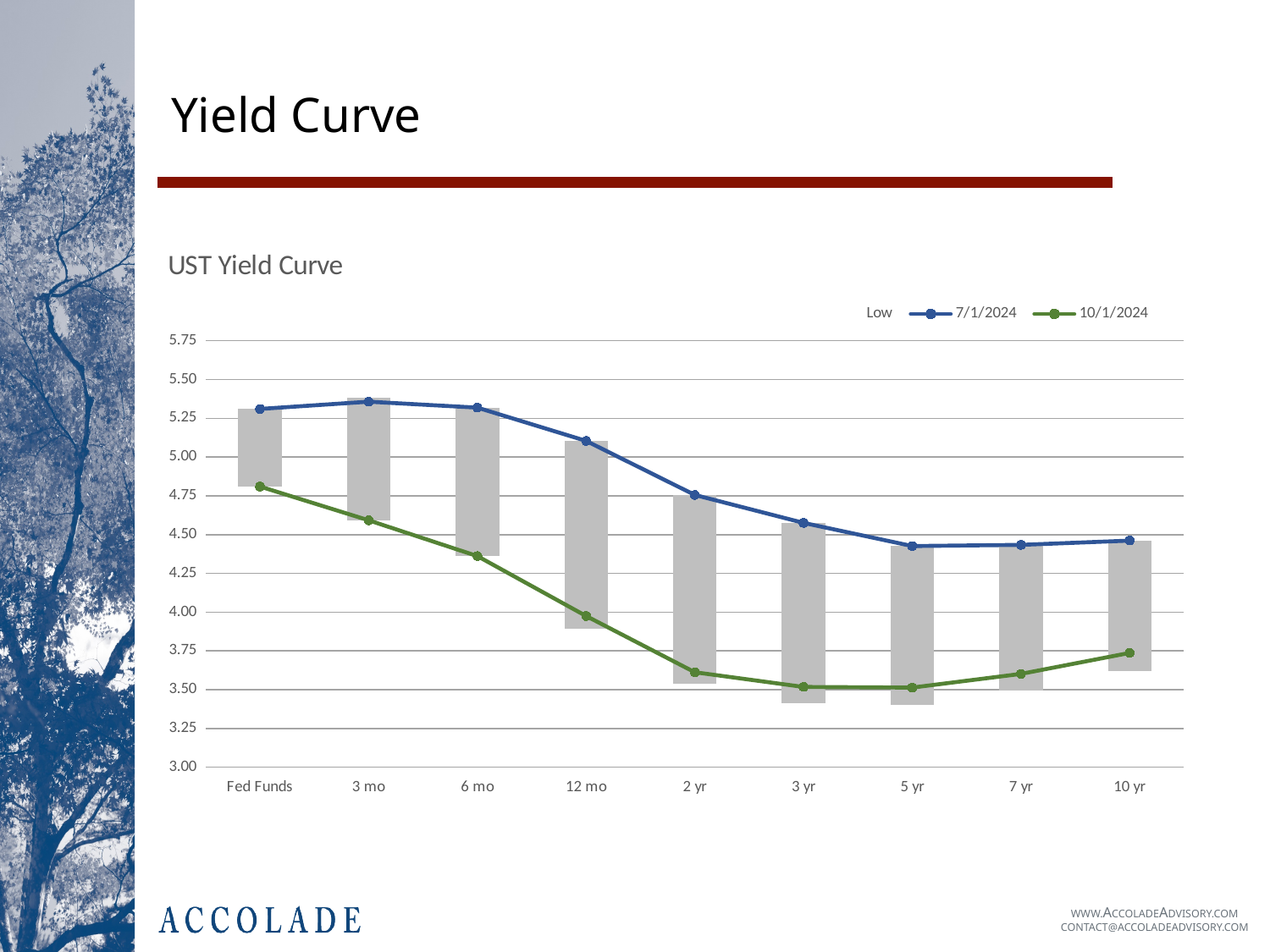
Which maturity has the highest value for the 10/1/2024 series? Fed Funds At 12 mo, which series has the larger value, 7/1/2024 or 10/1/2024? 7/1/2024 Is the 10/1/2024 value for 6 mo greater or less than 4.25? greater What colour is the line for the 10/1/2024 series? green Which maturity has the highest value for the 7/1/2024 series? 3 mo How many maturity categories are shown on the x axis of the UST Yield Curve chart? 9 Does the 10/1/2024 series rise or fall from Fed Funds to 5 yr? fall What kind of chart is the UST Yield Curve chart? combination bar and line chart Is the 10/1/2024 value for 2 yr greater or less than 3.50? greater Is the 7/1/2024 value for 5 yr greater or less than 4.50? less How many series does the legend of the UST Yield Curve chart list? 3